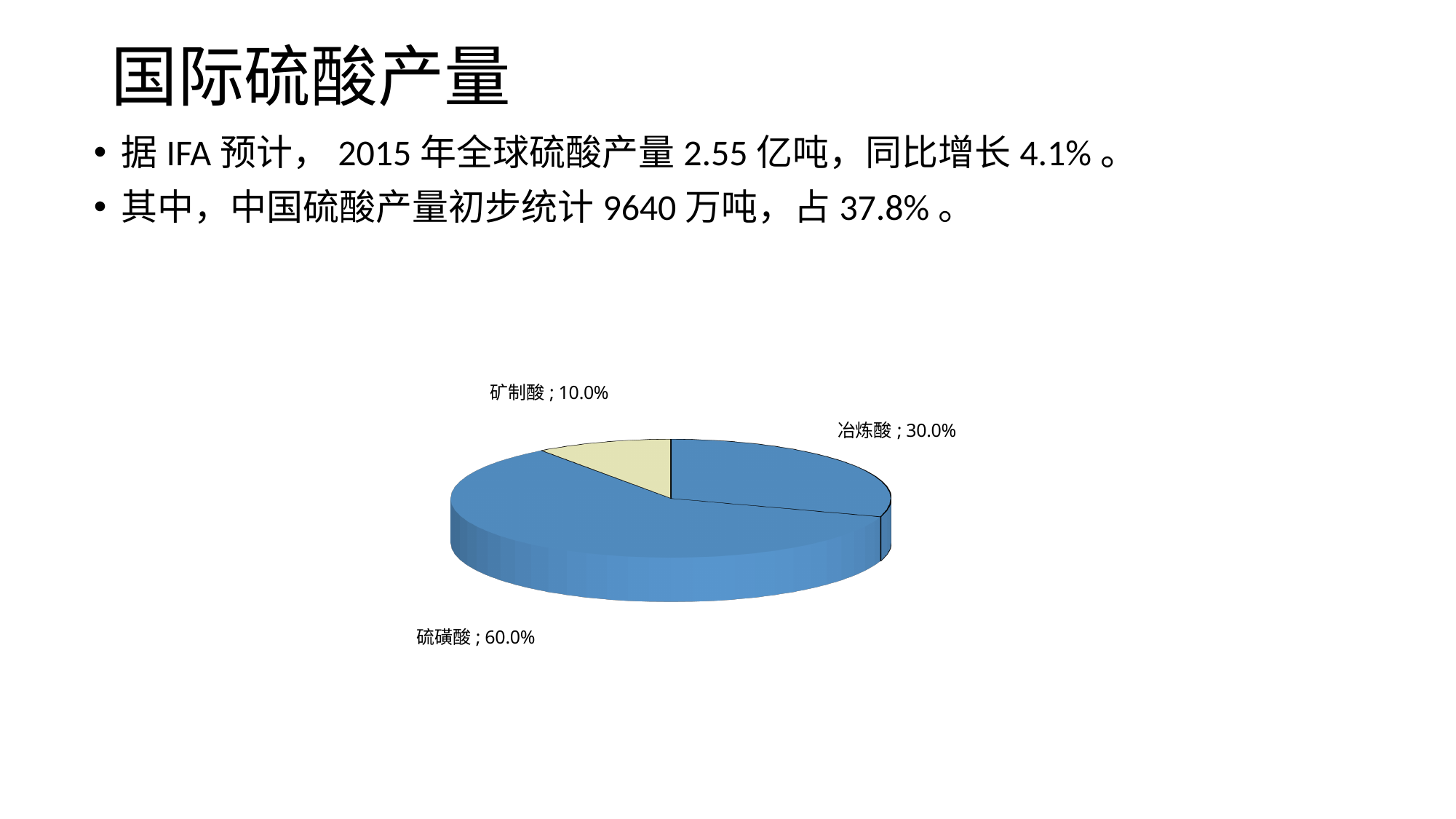
Which slice is larger, 冶炼酸 or 矿制酸? 冶炼酸 What share of the pie does 硫磺酸 account for? 60.0% How many categories are shown in the pie chart? 3 What share of the pie does 矿制酸 account for? 10.0% Which category has the smallest slice of the pie? 矿制酸 Which category has the largest slice of the pie? 硫磺酸 What is the combined share of 冶炼酸 and 矿制酸? 40.0% What colour is the 矿制酸 slice in the pie chart? Pale yellow What is the difference in percentage points between the 硫磺酸 and 冶炼酸 slices? 30.0% What is the difference in percentage points between the 冶炼酸 and 矿制酸 slices? 20.0% What kind of chart is shown on the slide? Pie chart What share of the pie does 冶炼酸 account for? 30.0%